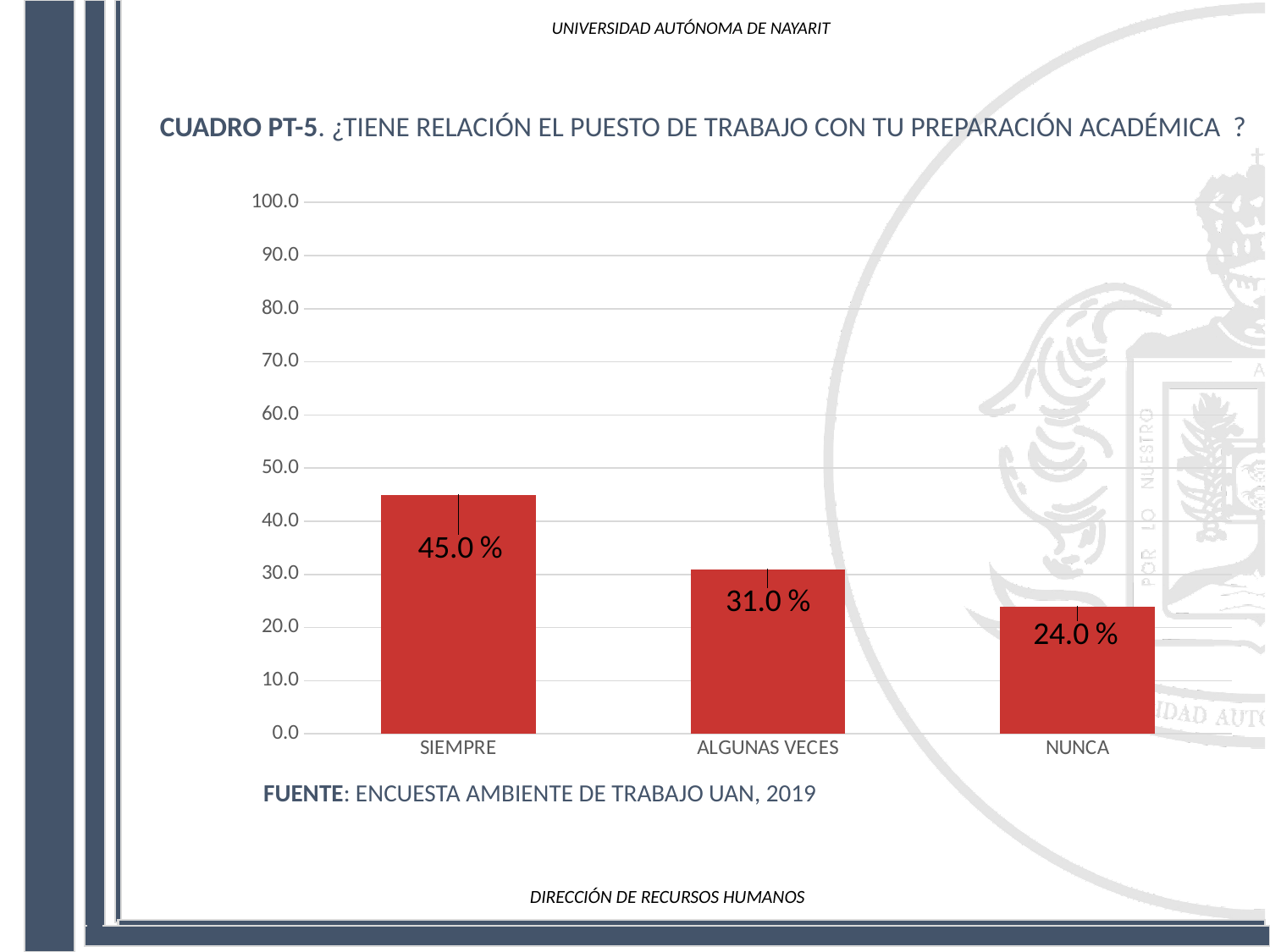
Which is larger, the value for ALGUNAS VECES or the value for NUNCA? ALGUNAS VECES What is the difference between the values for SIEMPRE and NUNCA? 21.0 % What is the value for SIEMPRE? 45.0 % What kind of chart is shown on the slide? bar chart What is the value for NUNCA? 24.0 % How many categories are shown on the x axis? 3 What is the difference between the values for ALGUNAS VECES and NUNCA? 7.0 % Do the values rise or fall from left to right along the x axis? fall What is the value for ALGUNAS VECES? 31.0 % Is the value for SIEMPRE greater or less than 50.0? less Which category has the lowest value? NUNCA Which category has the highest value? SIEMPRE